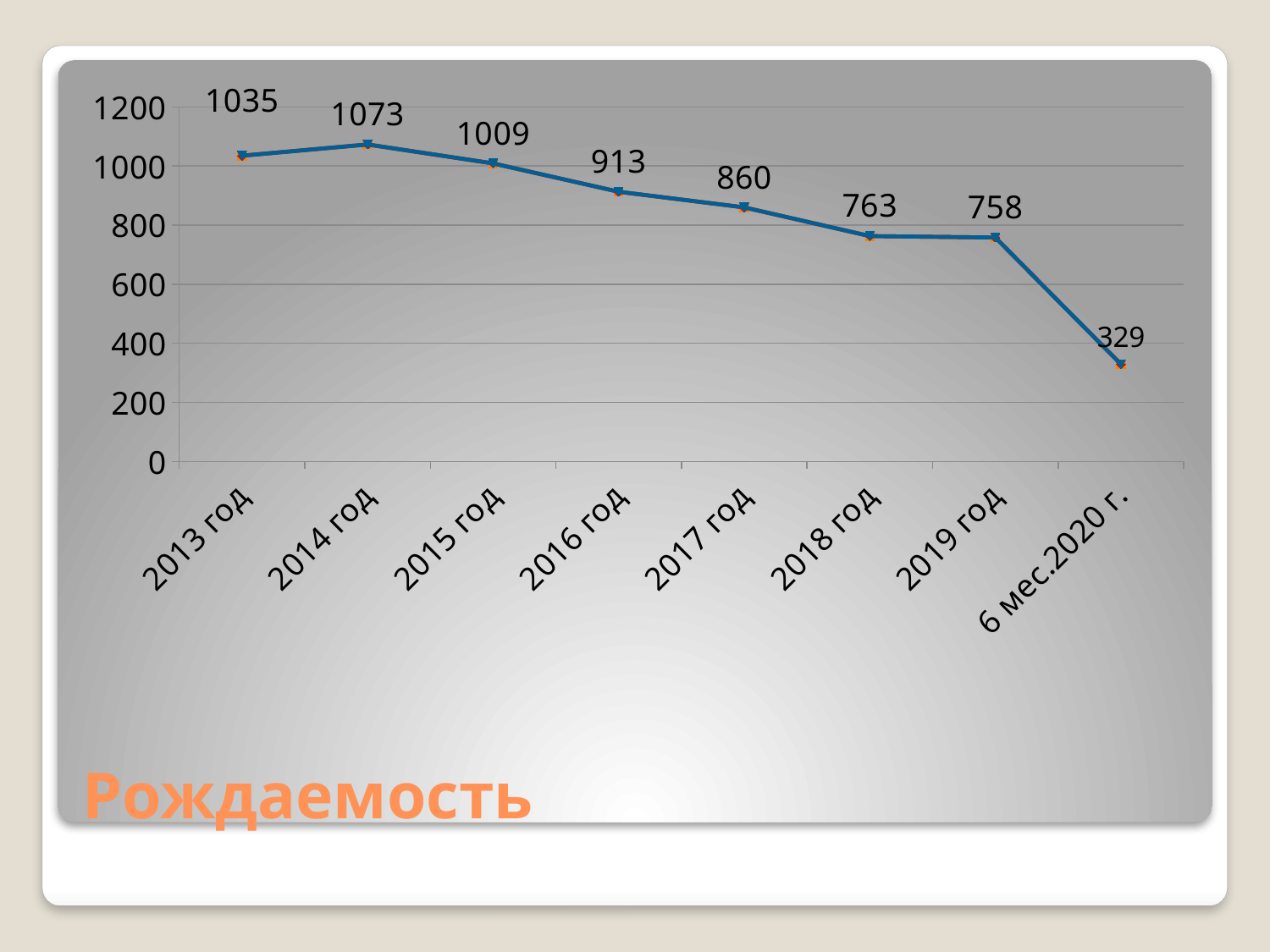
Which category has the highest value? 2014 год What kind of chart is shown on the slide? line chart What is the difference between the values for 2013 год and 2016 год? 122 Is the value for 2019 год greater or less than 800? less Which category has the lowest value? 6 мес.2020 г. What is the value for 6 мес.2020 г.? 329 Do the values generally rise or fall from 2014 год to 6 мес.2020 г.? fall Which is larger, the value for 2015 год or the value for 2018 год? 2015 год How many categories are shown on the x axis? 8 What is the value for 2017 год? 860 What is the title of the slide? Рождаемость What is the value for 2014 год? 1073